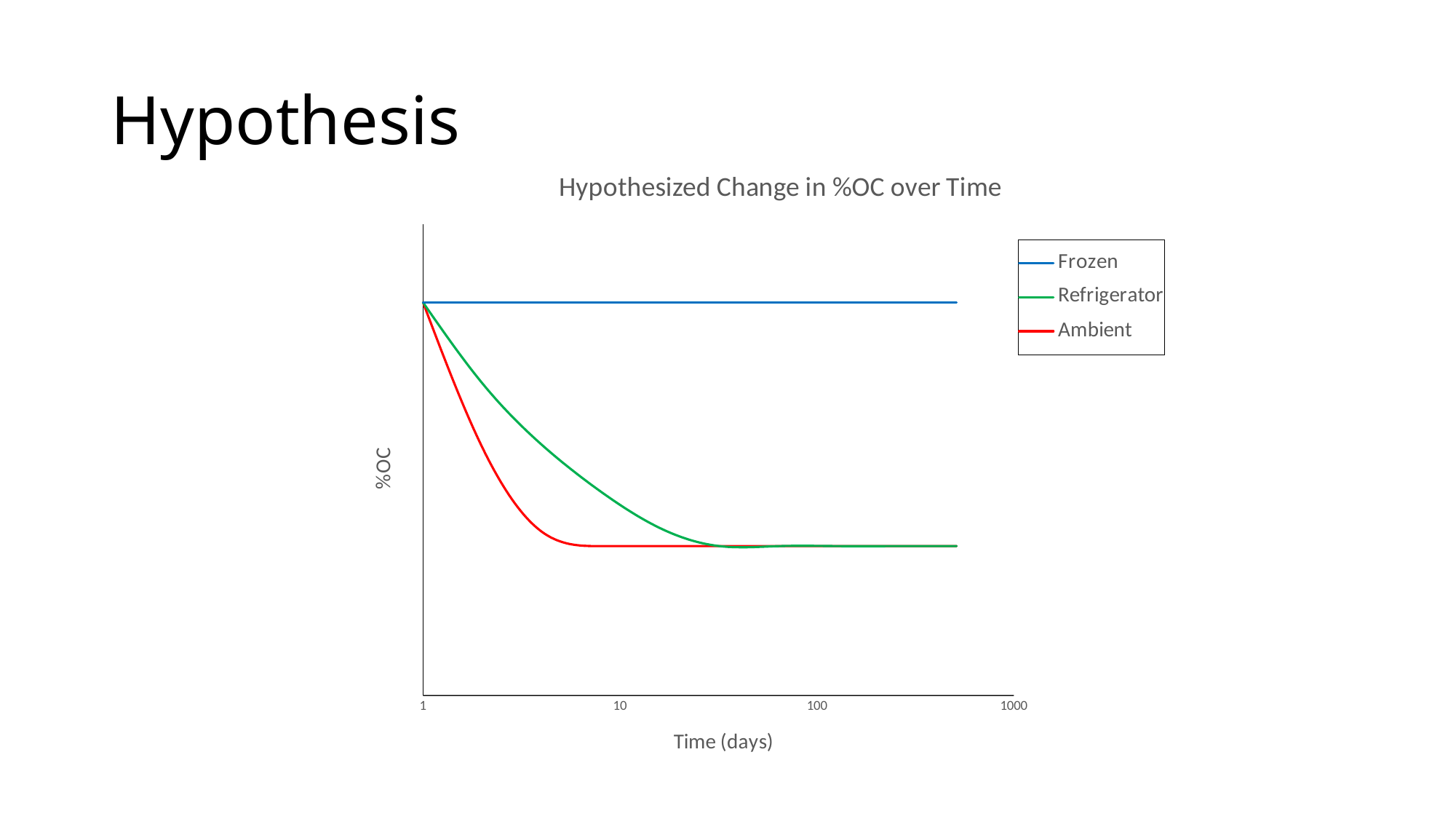
Which series has the highest %OC at 100 days? Frozen Does the Refrigerator series rise or fall between 1 and 10 days? Fall What is the title of the chart? Hypothesized Change in %OC over Time Which series reaches its lowest plateau first, Refrigerator or Ambient? Ambient At 10 days, which series has the lowest %OC? Ambient What kind of chart is shown on the slide? Line chart Does the Frozen series rise, fall, or stay flat as time increases? Stays flat How many tick labels are shown on the x axis? 4 How many series does the legend list? 3 Does the Ambient series rise or fall over the first 10 days? Fall What is the label of the x axis? Time (days) At 10 days, which series has a higher %OC, Refrigerator or Ambient? Refrigerator